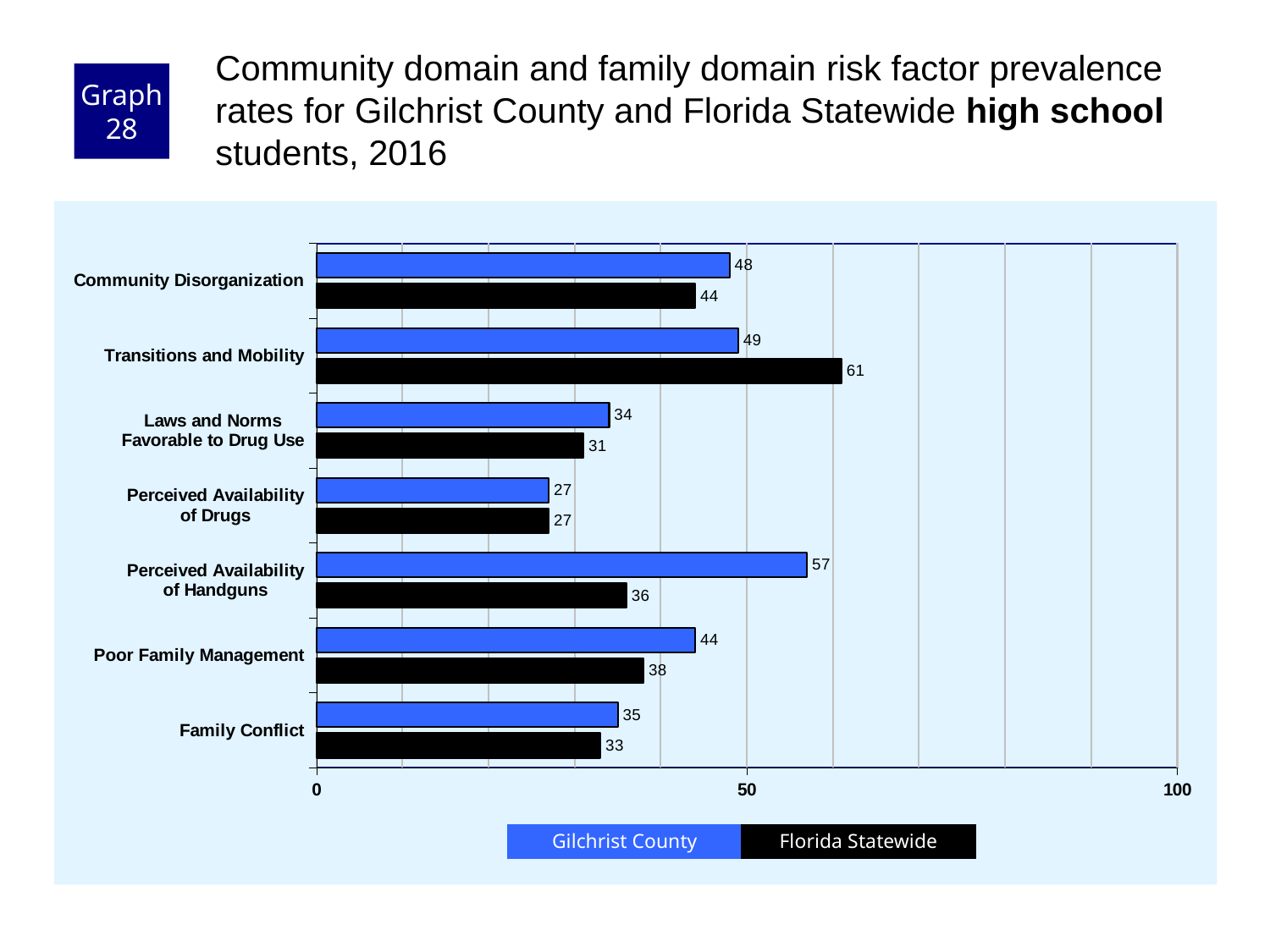
How many risk factors are shown on the chart? 7 Which colour represents Florida Statewide in the chart? Black What kind of chart is shown on the slide? Bar chart Which risk factor has the lowest Florida Statewide value? Perceived Availability of Drugs Which is larger for Transitions and Mobility: the Gilchrist County value or the Florida Statewide value? Florida Statewide Which risk factor has the highest Gilchrist County value? Perceived Availability of Handguns How many series does the legend list? 2 What is the difference between the Gilchrist County and Florida Statewide values for Perceived Availability of Handguns? 21 What is the Florida Statewide value for Poor Family Management? 38 What is the Gilchrist County value for Perceived Availability of Handguns? 57 Is the Gilchrist County value for Community Disorganization greater or less than 50? less What is the Florida Statewide value for Transitions and Mobility? 61